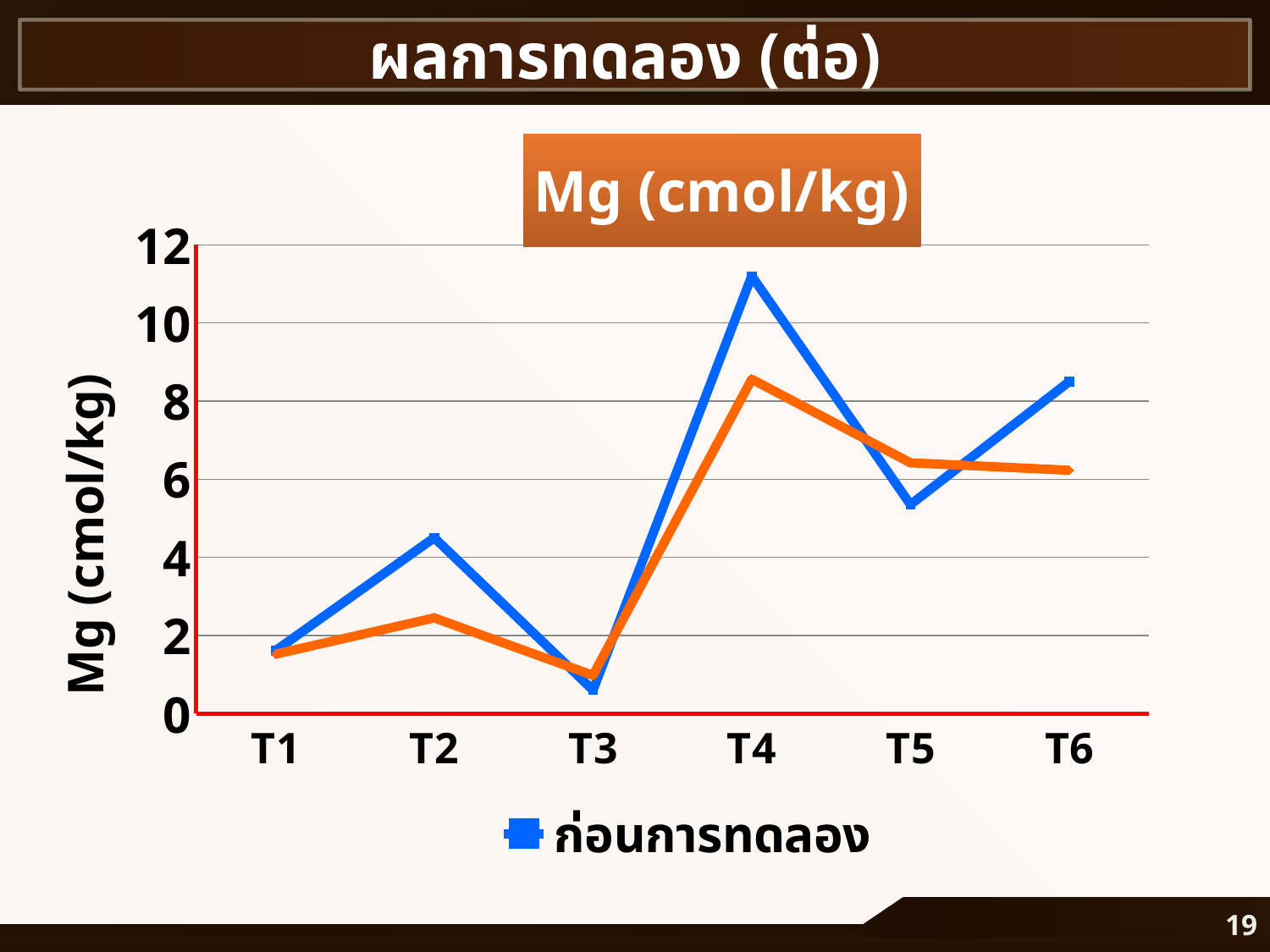
What is the label of the y axis of the chart? Mg (cmol/kg) How many series does the legend of the chart list? 1 How many categories are shown on the x axis of the chart? 6 What kind of chart is shown on the slide? line chart At which category does the ก่อนการทดลอง (blue) line reach its lowest value? T3 Is the value of the ก่อนการทดลอง (blue) line at T4 greater or less than 10? greater At which category does the orange line reach its highest value? T4 At T5, which line has the larger value, the blue ก่อนการทดลอง line or the orange line? the orange line Does the ก่อนการทดลอง (blue) line rise or fall from T4 to T5? fall At which category does the ก่อนการทดลอง (blue) line reach its highest value? T4 What is the title of the chart? Mg (cmol/kg) Is the value of the ก่อนการทดลอง (blue) line at T3 greater or less than 2? less